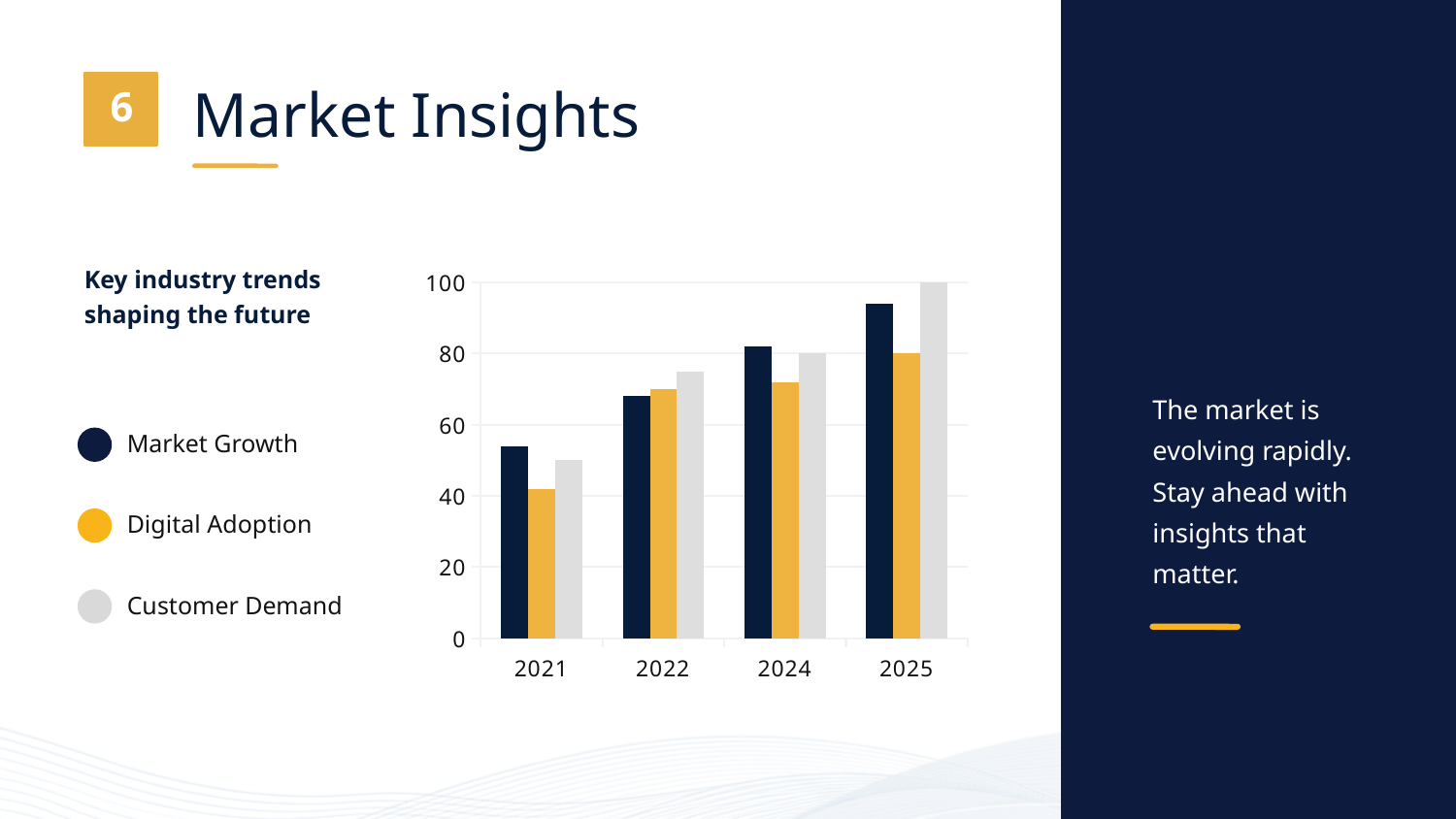
Which series is shown in yellow in the chart? Digital Adoption Is the value for Market Growth in 2025 greater or less than 80? greater In 2021, which is larger: Market Growth or Digital Adoption? Market Growth What kind of chart is shown on the slide? Bar chart In which year is the Digital Adoption bar the lowest? 2021 Do the Market Growth values rise or fall from 2021 to 2025? Rise Is the value for Market Growth in 2021 greater or less than 40? greater Is the value for Digital Adoption in 2022 greater or less than 60? greater How many years are shown on the x axis of the chart? 4 How many series does the legend list? 3 In which year is the Market Growth bar the highest? 2025